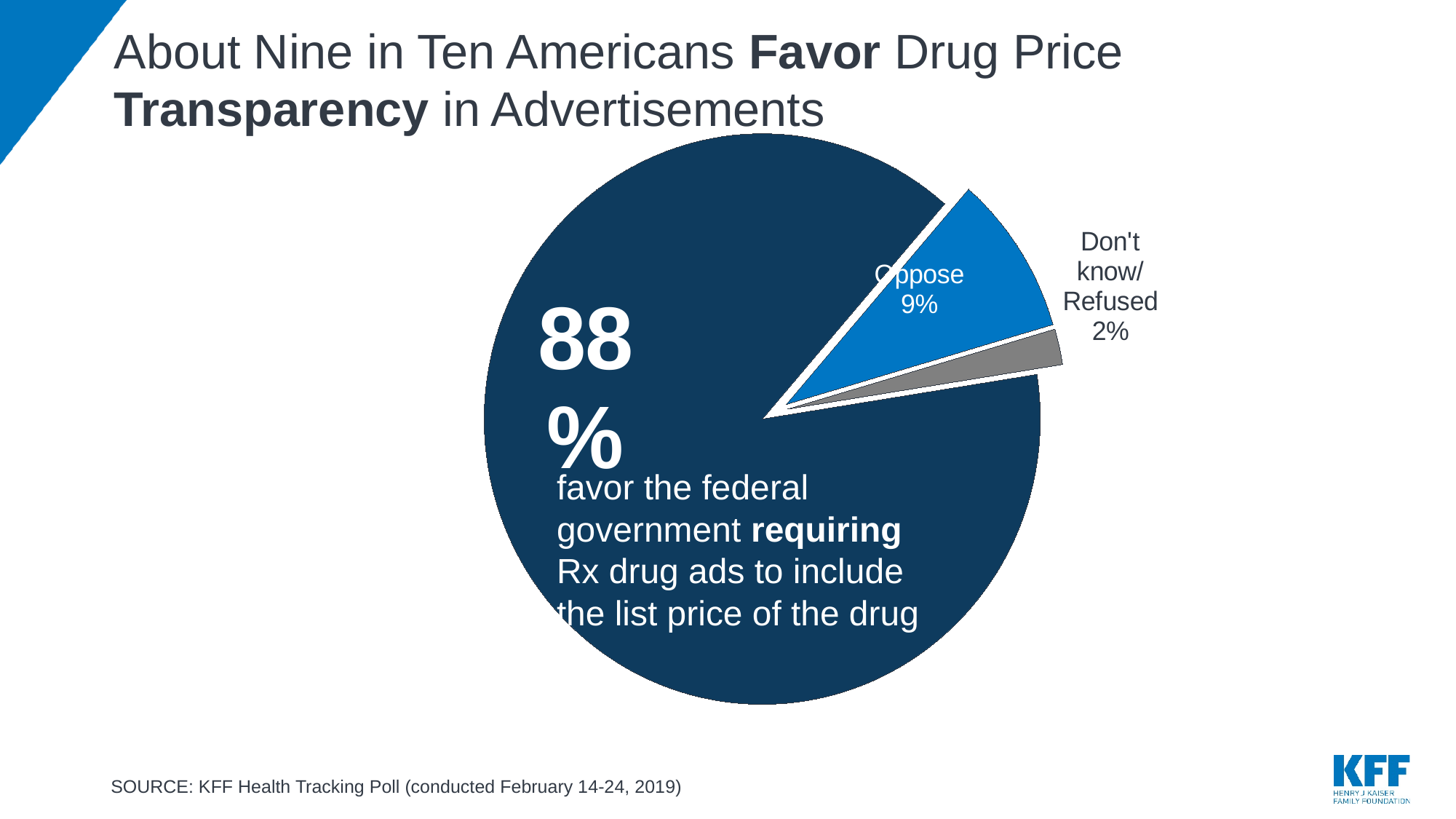
What percentage answered Don't know/Refused? 2% What colour is the Oppose slice? light blue What percentage of Americans favor the federal government requiring Rx drug ads to include the list price of the drug? 88% Which response has the largest share of the pie? Favor Which is larger, the Oppose share or the Don't know/Refused share? Oppose What is the difference in percentage points between those who favor and those who oppose? 79 What is the difference in percentage points between Oppose and Don't know/Refused? 7 What kind of chart is shown on the slide? pie chart Which response has the smallest share of the pie? Don't know/Refused How many slices does the pie chart have? 3 What is the source of the data shown in the chart? KFF Health Tracking Poll (conducted February 14-24, 2019) What percentage oppose the requirement? 9%